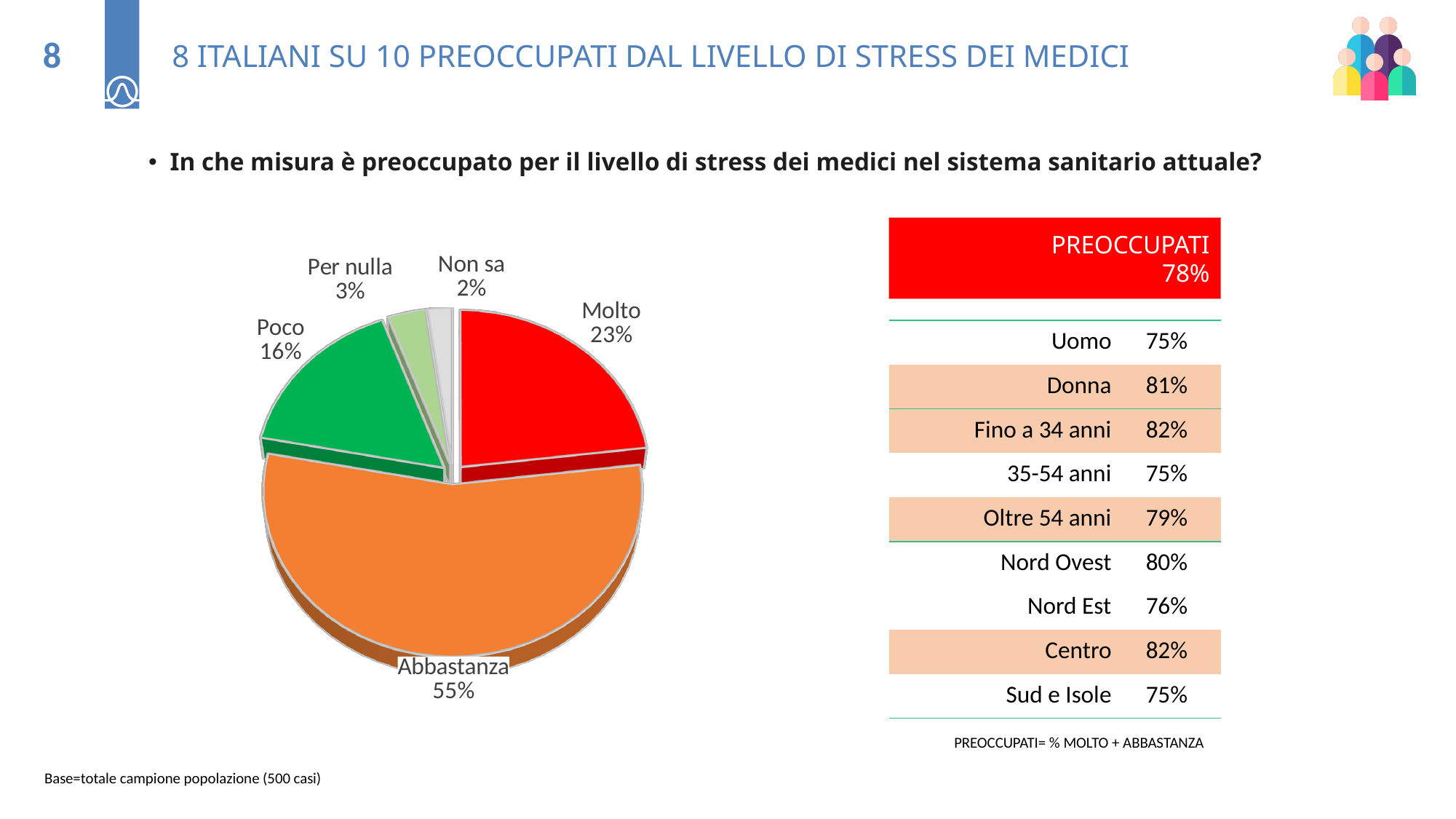
What colour is the "Abbastanza" slice in the pie chart? orange What kind of chart is shown on the slide? pie chart What is the value for "Molto" in the pie chart? 23% Which is larger in the pie chart, "Poco" or "Molto"? Molto What is the combined share of "Molto" and "Abbastanza" in the pie chart? 78% Which category has the largest slice in the pie chart? Abbastanza What is the value for "Poco" in the pie chart? 16% What is the difference between the "Abbastanza" and "Molto" slices? 32% What share of the pie does "Abbastanza" represent? 55% Which category has the smallest slice in the pie chart? Non sa What is the value for "Per nulla" in the pie chart? 3% How many slices does the pie chart have? 5